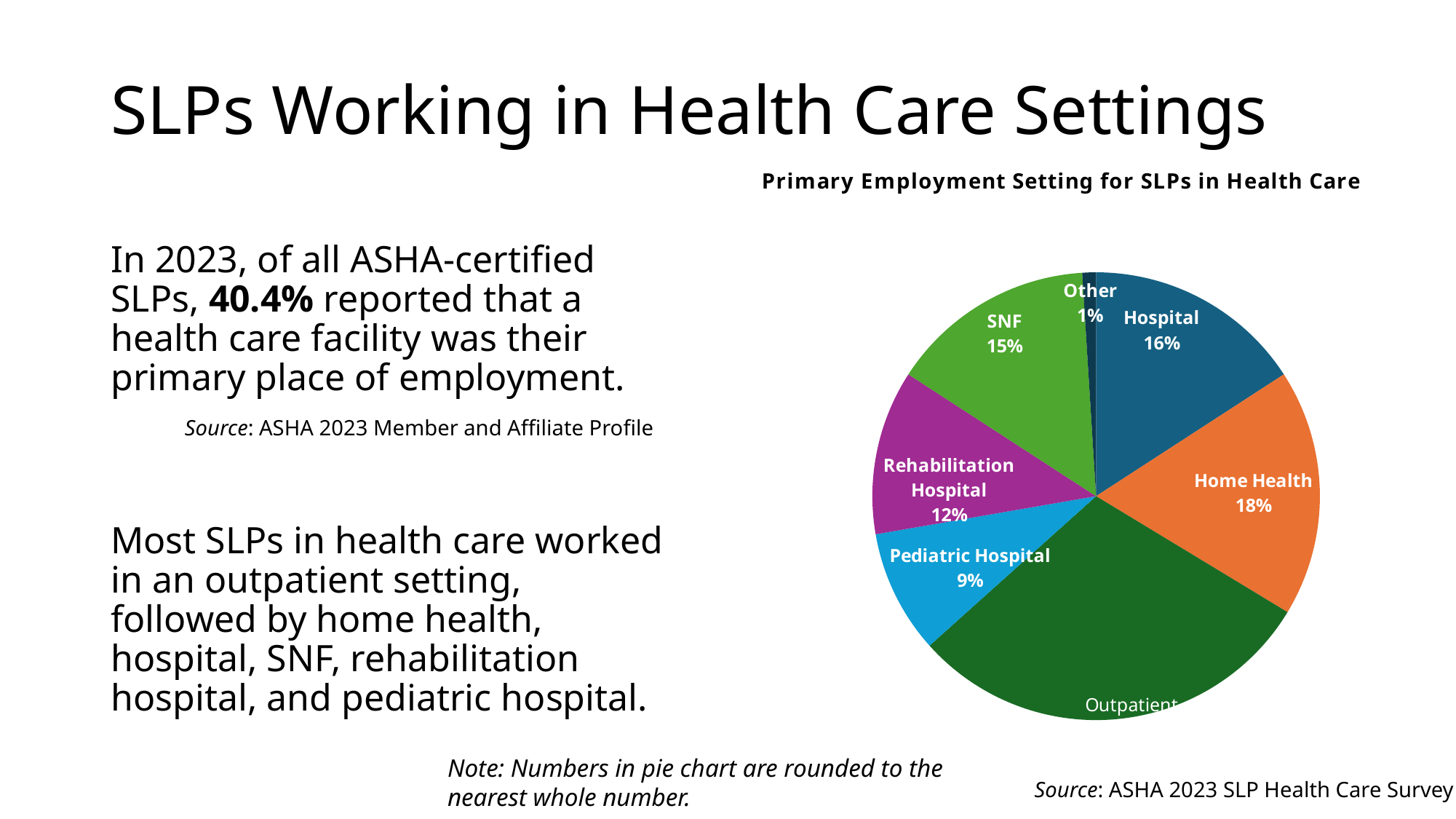
Which setting has the smallest slice of the pie chart? Other Which is larger, the SNF slice or the Rehabilitation Hospital slice? SNF What type of chart is shown on the slide? Pie chart What share of the pie chart is labelled Hospital? 16% How many settings are shown in the pie chart? 7 What is the title of the chart? Primary Employment Setting for SLPs in Health Care Which setting has the largest slice of the pie chart? Outpatient What percentage is shown for Rehabilitation Hospital? 12% What percentage is shown for SNF in the pie chart? 15% What percentage of SLPs in health care reported Home Health as their primary employment setting? 18% How many percentage points higher is Home Health than Hospital? 2 What percentage is shown for Pediatric Hospital? 9%